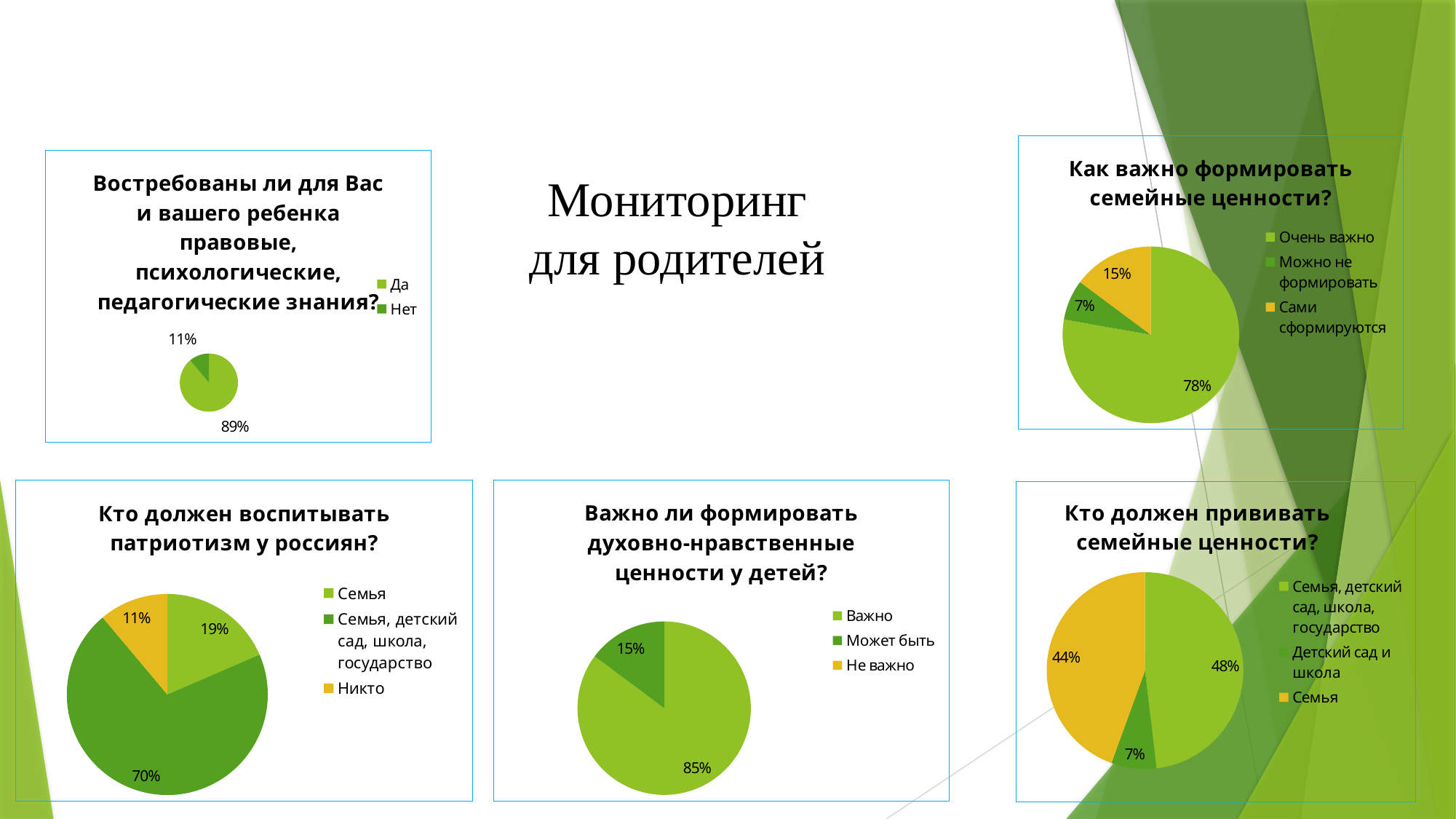
What type of chart is used in the chart titled "Кто должен прививать семейные ценности?"? Pie chart In the chart titled "Кто должен воспитывать патриотизм у россиян?", what share is labelled for "Семья, детский сад, школа, государство"? 70% In the chart titled "Востребованы ли для Вас и вашего ребенка правовые, психологические, педагогические знания?", what share of respondents answered "Нет"? 11% In the chart titled "Как важно формировать семейные ценности?", what share is labelled for "Очень важно"? 78% In the chart titled "Кто должен воспитывать патриотизм у россиян?", which is larger: "Семья" or "Никто"? Семья In the chart titled "Кто должен прививать семейные ценности?", which category has the largest slice? Семья, детский сад, школа, государство In the chart titled "Востребованы ли для Вас и вашего ребенка правовые, психологические, педагогические знания?", what share of respondents answered "Да"? 89% In the chart titled "Как важно формировать семейные ценности?", which category has the smallest slice? Можно не формировать In the chart titled "Важно ли формировать духовно-нравственные ценности у детей?", what share is labelled for "Может быть"? 15% In the chart titled "Важно ли формировать духовно-нравственные ценности у детей?", what share is labelled for "Важно"? 85% In the chart titled "Как важно формировать семейные ценности?", what is the difference between the "Сами сформируются" and "Можно не формировать" shares? 8% In the chart titled "Кто должен воспитывать патриотизм у россиян?", how many categories does the legend list? 3